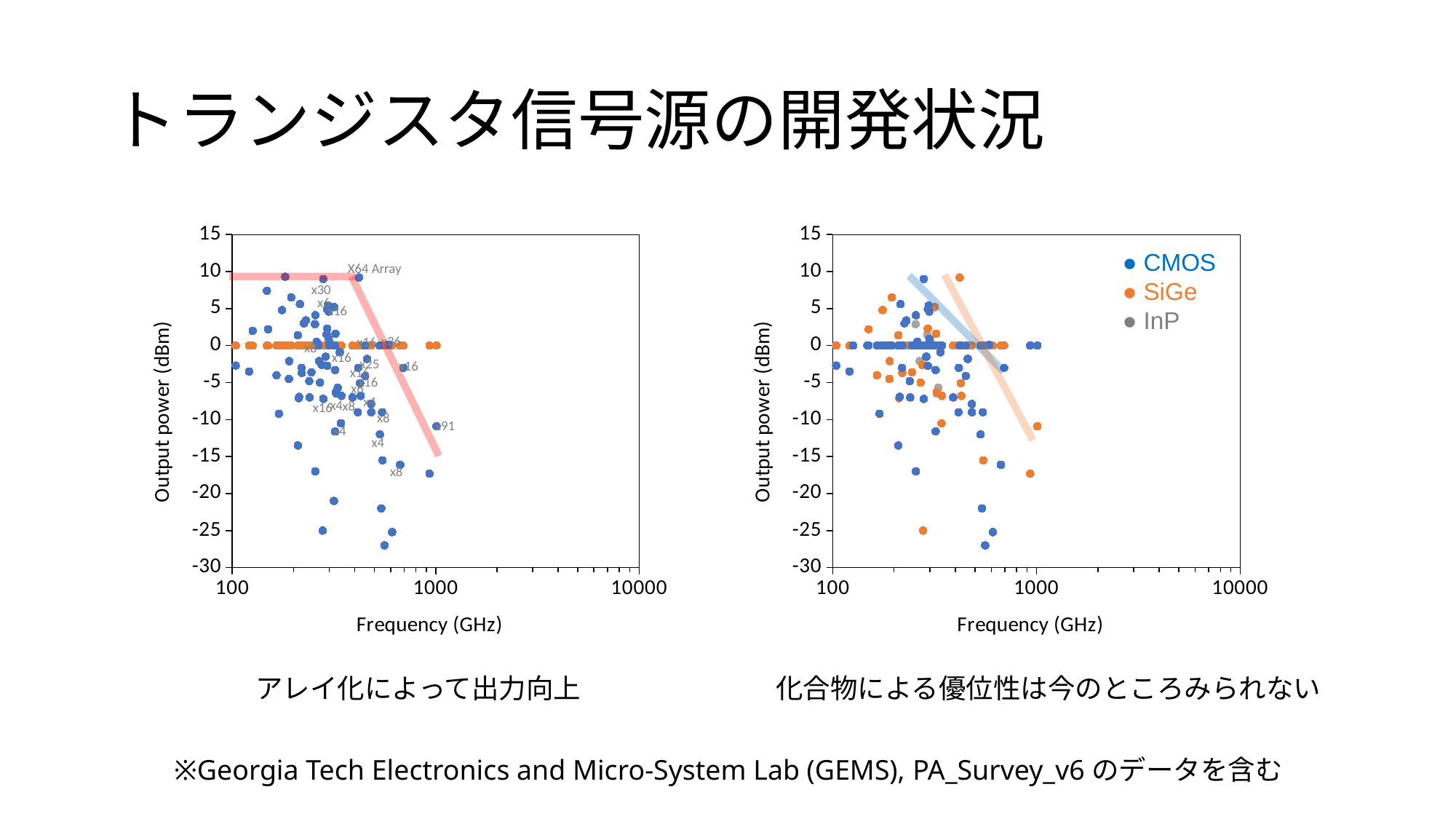
In the left chart, is the output power of the point labelled "x91" greater or less than -5 dBm? less How many charts are shown on the slide? 2 In the right chart, do the shaded trend lines show output power rising or falling as frequency increases? falling In the left chart, which point has the higher output power, the one labelled "X64 Array" or the one labelled "x91"? X64 Array How many series does the legend of the right chart list? 3 In the left chart, which labelled point has the highest output power? X64 Array In the right chart, is the highest SiGe point greater or less than 5 dBm? greater What are the legend entries of the right chart? CMOS, SiGe, InP What kind of chart is the left chart on the slide? scatter chart In the left chart, is the output power of the point labelled "X64 Array" greater or less than 5 dBm? greater What is the x-axis label of the left chart? Frequency (GHz)